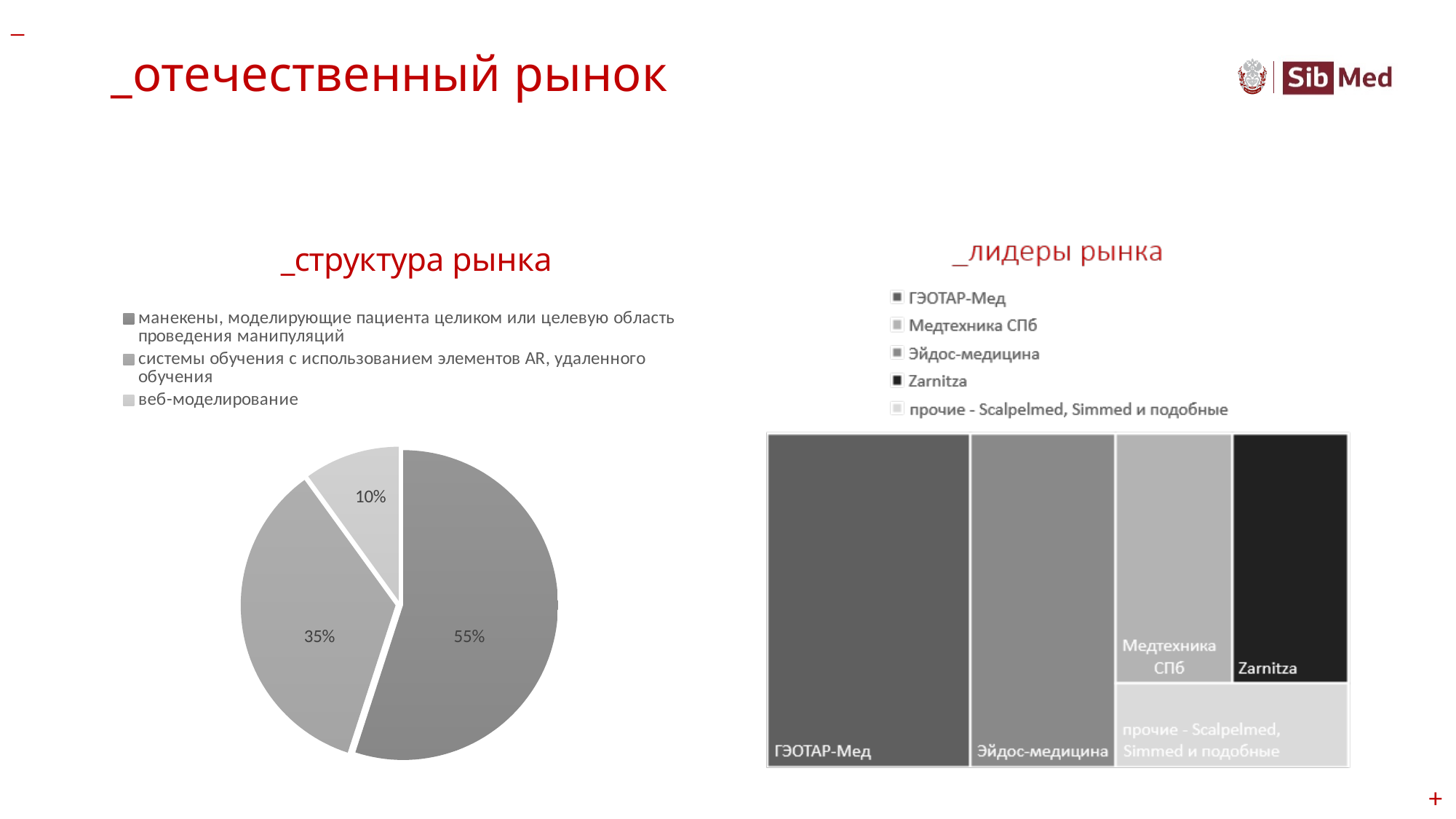
In the pie chart titled _структура рынка, what is the difference in percentage points between the largest slice and the slice for веб-моделирование? 45 In the pie chart titled _структура рынка, how many slices does the pie have? 3 In the pie chart titled _структура рынка, which category has the largest slice? манекены, моделирующие пациента целиком или целевую область проведения манипуляций In the pie chart titled _структура рынка, what share is shown for веб-моделирование? 10% In the pie chart titled _структура рынка, which category has the smallest slice? веб-моделирование In the chart titled _лидеры рынка, how many entries does the legend list? 5 In the pie chart titled _структура рынка, what share is shown for манекены, моделирующие пациента целиком или целевую область проведения манипуляций? 55% What type of chart is shown under the title _структура рынка? pie chart In the chart titled _лидеры рынка, which occupies a larger area: Эйдос-медицина or Zarnitza? Эйдос-медицина In the chart titled _лидеры рынка, which company occupies the largest area? ГЭОТАР-Мед In the pie chart titled _структура рынка, what share is shown for системы обучения с использованием элементов AR, удаленного обучения? 35% In the chart titled _лидеры рынка, which legend entry is shown in black? Zarnitza